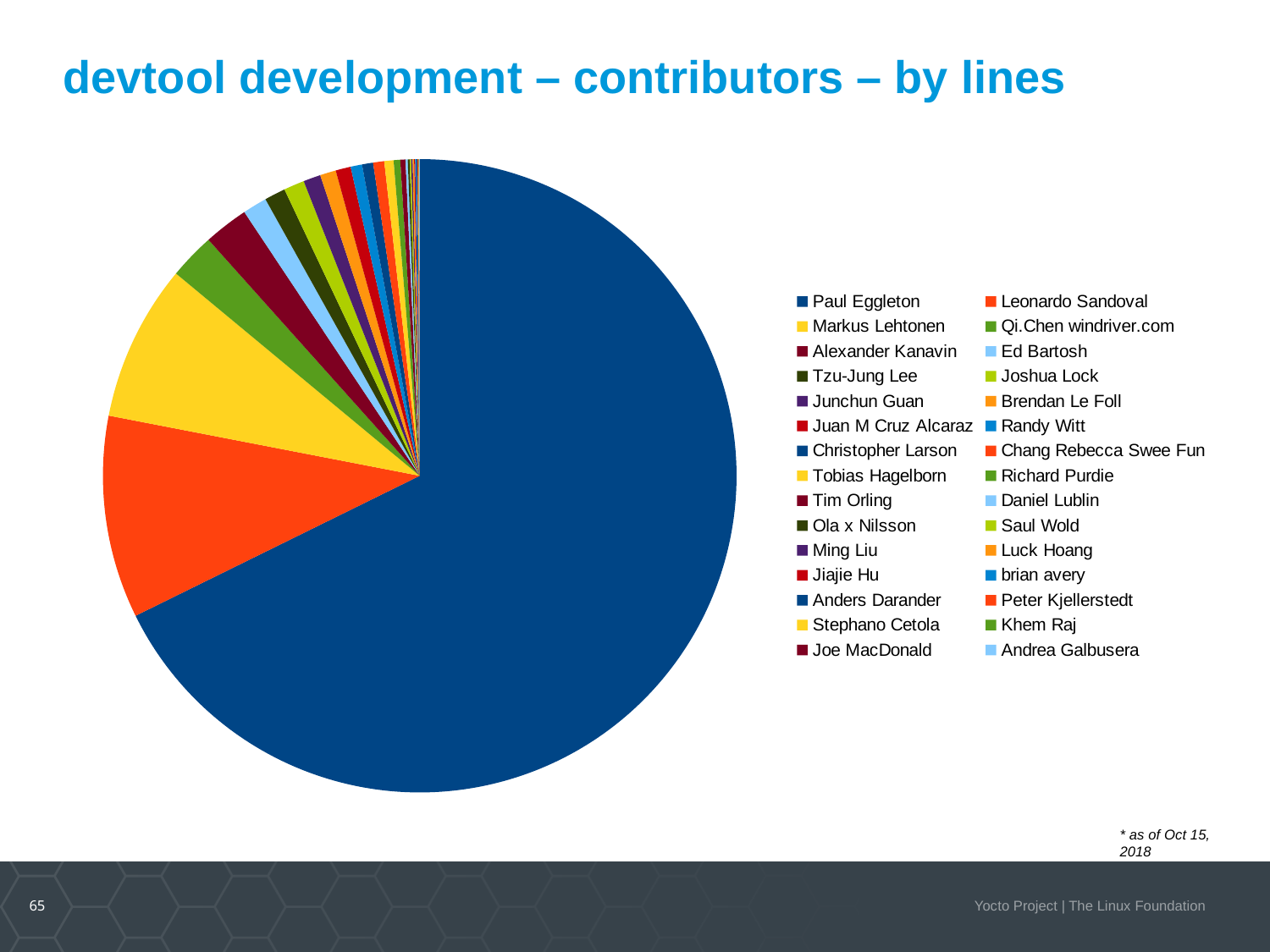
Does Paul Eggleton's slice take up more or less than half of the pie? more What colour is the slice for Paul Eggleton? dark blue Which slice is larger, Leonardo Sandoval or Markus Lehtonen? Leonardo Sandoval What kind of chart is shown on the slide? pie chart How many contributors are listed in the legend? 30 What is the title of the slide? devtool development – contributors – by lines Which slice is larger, Markus Lehtonen or Qi.Chen windriver.com? Markus Lehtonen Which contributor has the largest slice of the pie? Paul Eggleton